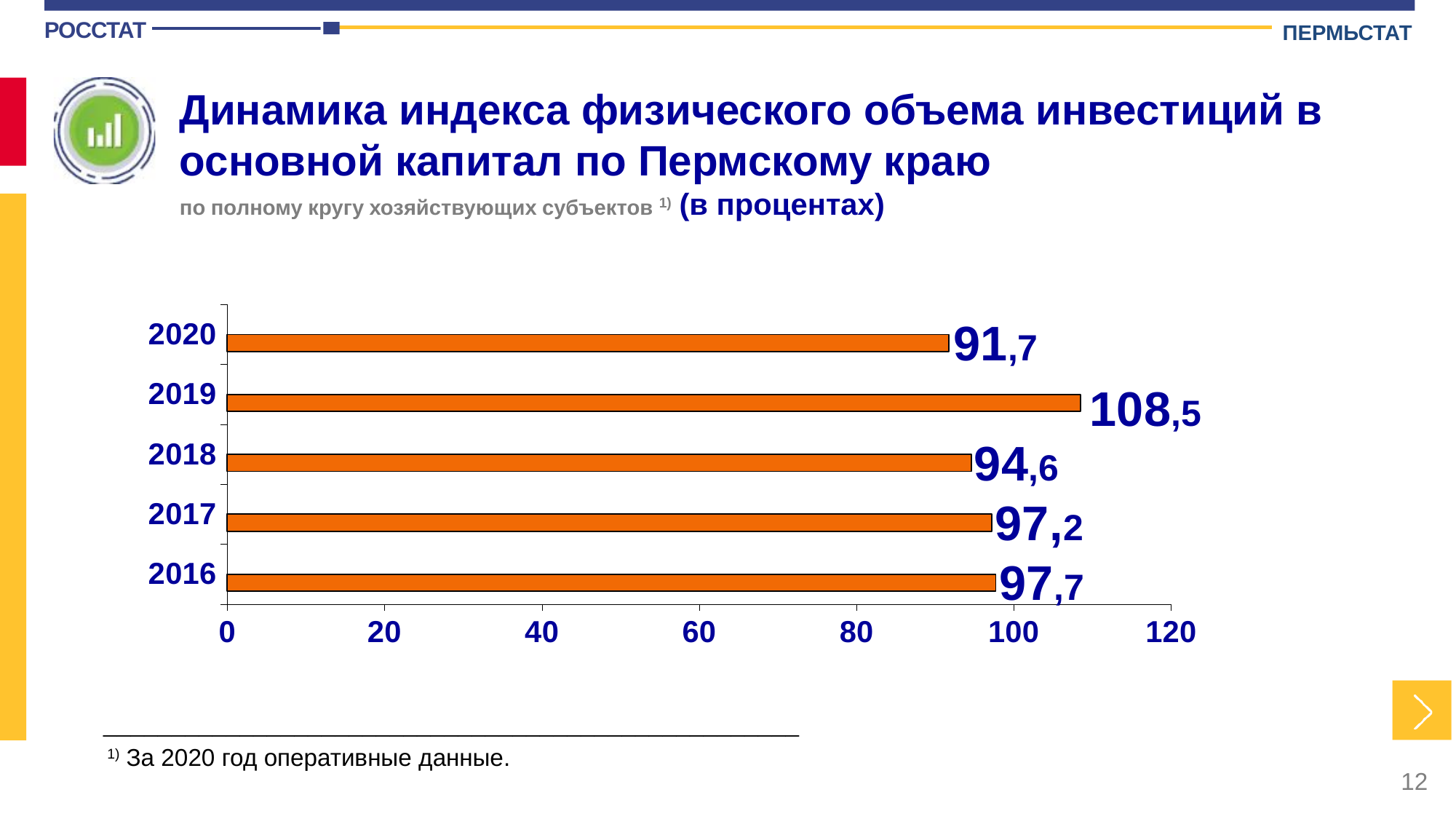
How many years are shown in the chart? 5 What is the value for 2017? 97,2 Which year has the lowest value? 2020 What is the difference between the values for 2019 and 2020? 16,8 Which is larger, the value for 2017 or the value for 2018? 2017 What is the value for 2018? 94,6 What is the value for 2016? 97,7 What kind of chart is shown on the slide? bar chart What is the value for 2020? 91,7 What is the value for 2019? 108,5 Which year has the highest value? 2019 Is the value for 2019 greater or less than 100? greater